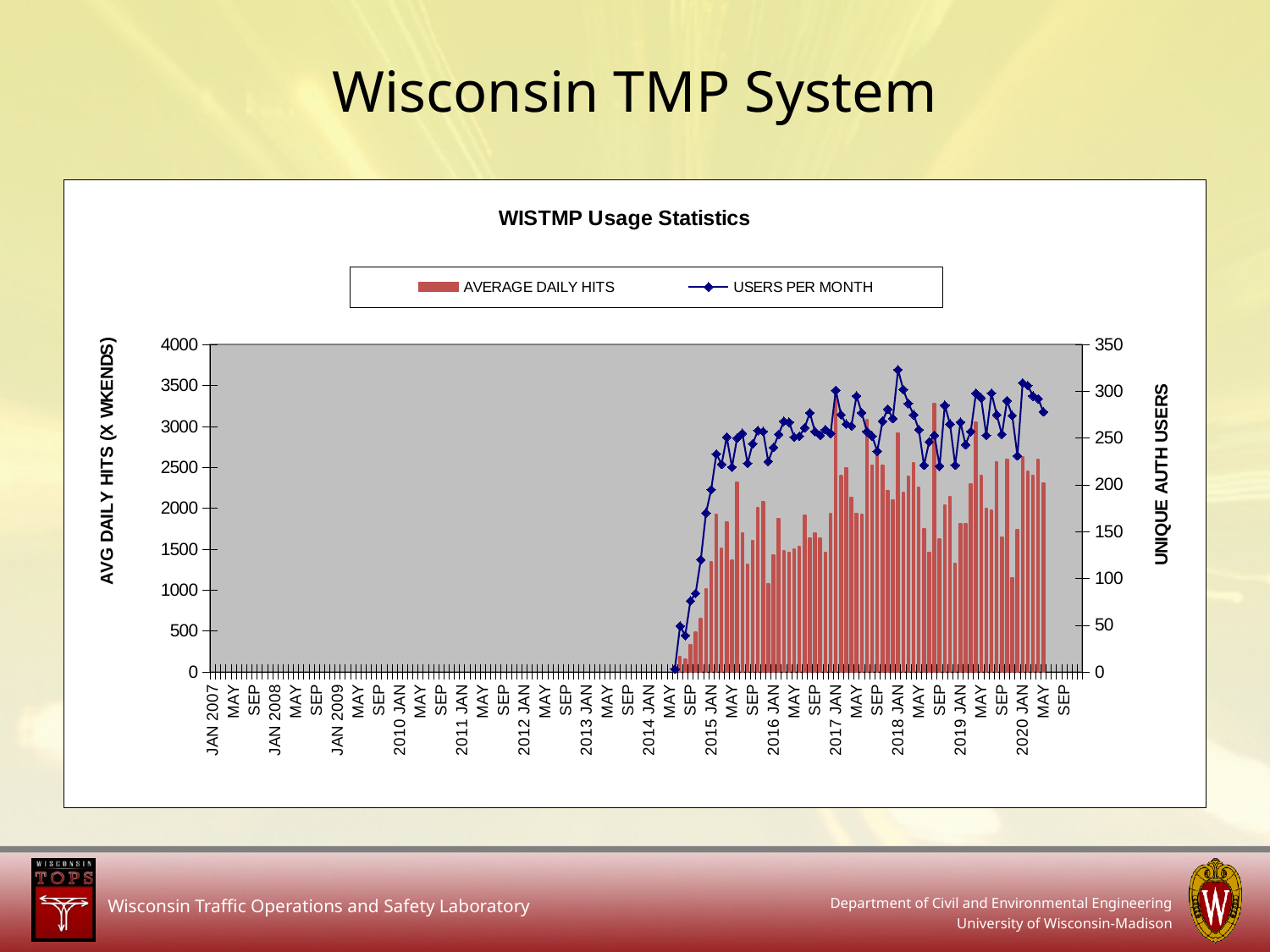
How many series does the chart legend list? 2 What is the highest value shown on the right vertical axis? 350 What is the title of the chart? WISTMP Usage Statistics Is the USERS PER MONTH value for JAN 2018 greater or less than 300? greater What is the highest value shown on the left vertical axis? 4000 Which series is drawn as a line with diamond markers? USERS PER MONTH What kind of chart is shown? Combined bar and line chart What is the first month shown on the x axis? JAN 2007 Does the USERS PER MONTH series rise or fall between SEP 2014 and JAN 2015? rise Is the USERS PER MONTH value for JAN 2016 greater or less than 200? greater